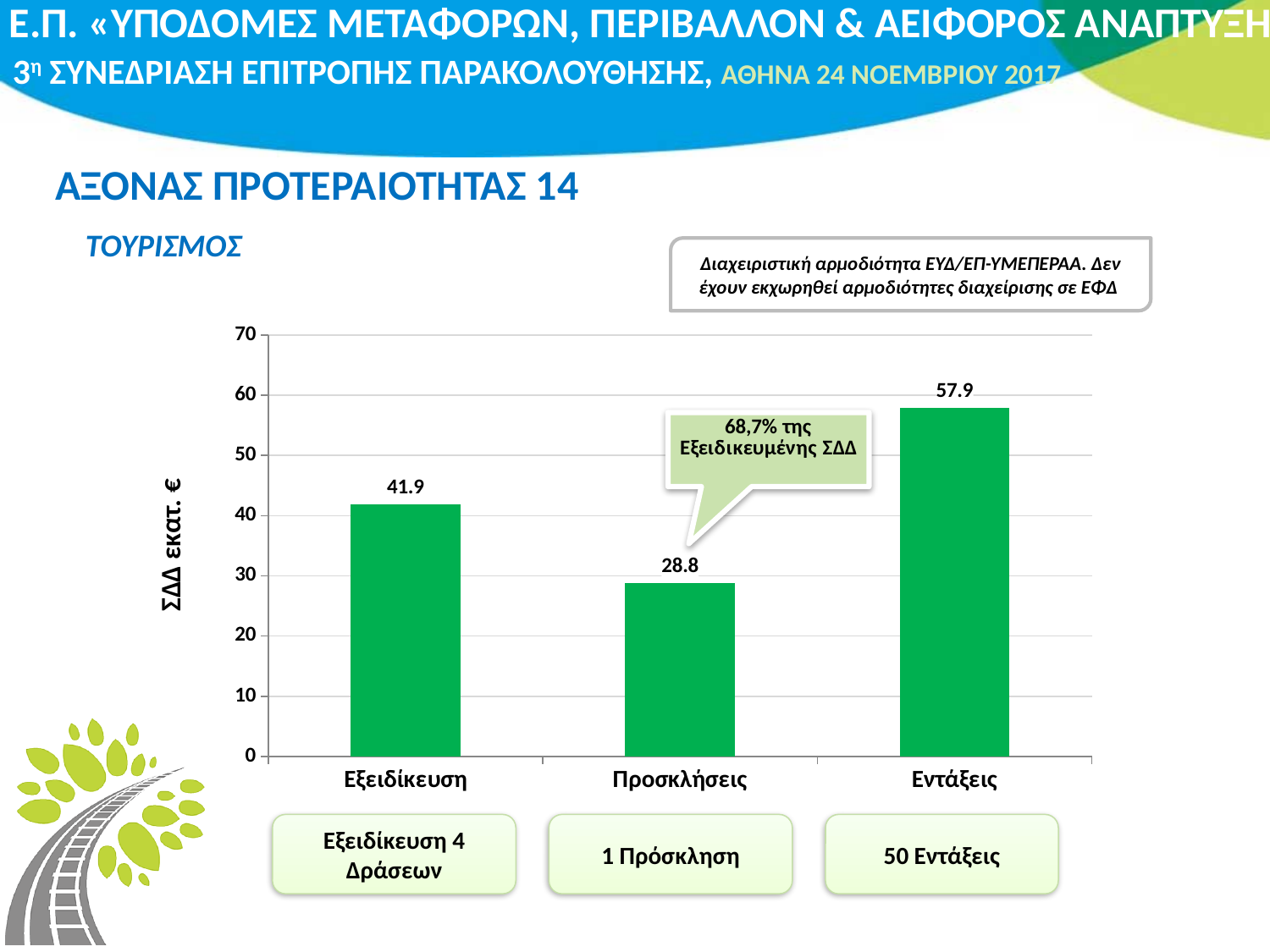
Which is larger, the value for Εξειδίκευση or the value for Εντάξεις? Εντάξεις Which category has the highest value? Εντάξεις What is the value for Προσκλήσεις? 28.8 What is the value for Εξειδίκευση? 41.9 What is the difference between the values for Εντάξεις and Προσκλήσεις? 29.1 What is the label of the vertical axis? ΣΔΔ εκατ. € Which category has the lowest value? Προσκλήσεις How many categories are shown on the x axis? 3 Is the value for Εντάξεις greater or less than 50? greater What is the difference between the values for Εξειδίκευση and Προσκλήσεις? 13.1 What is the value for Εντάξεις? 57.9 What kind of chart is shown on the slide? bar chart